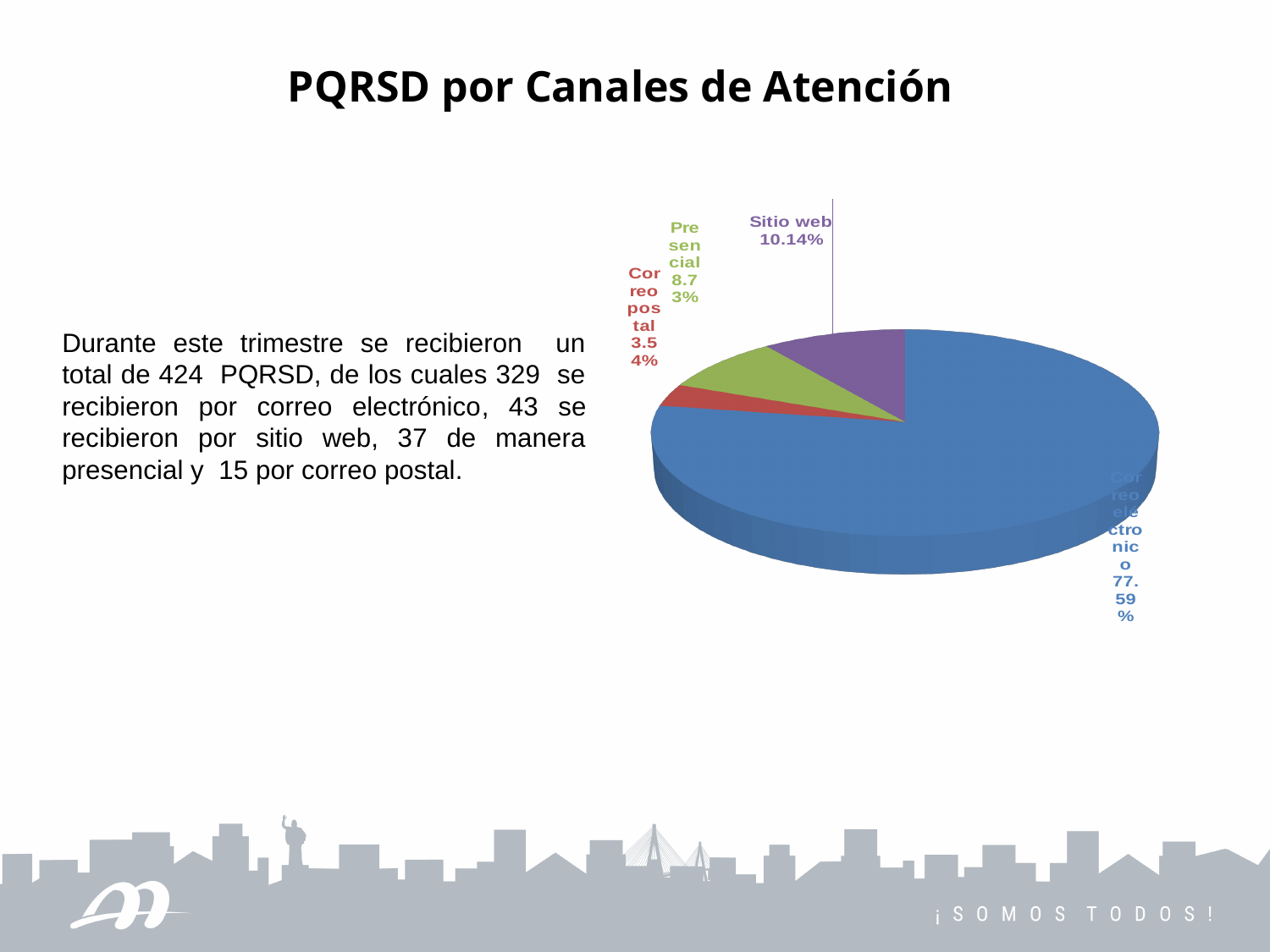
Which channel has the largest slice of the pie? Correo electrónico What is the difference in percentage points between the Sitio web and Presencial slices? 1.41 What kind of chart is shown on the slide? pie chart What is the difference in percentage points between the Correo electrónico and Sitio web slices? 67.45 Which slice is larger, Sitio web or Presencial? Sitio web What colour is the Correo electrónico slice? blue How many slices does the pie chart have? 4 What share of the pie does Correo electrónico represent? 77.59% What share of the pie does Presencial represent? 8.73% What share of the pie does Correo postal represent? 3.54% Which channel has the smallest slice of the pie? Correo postal